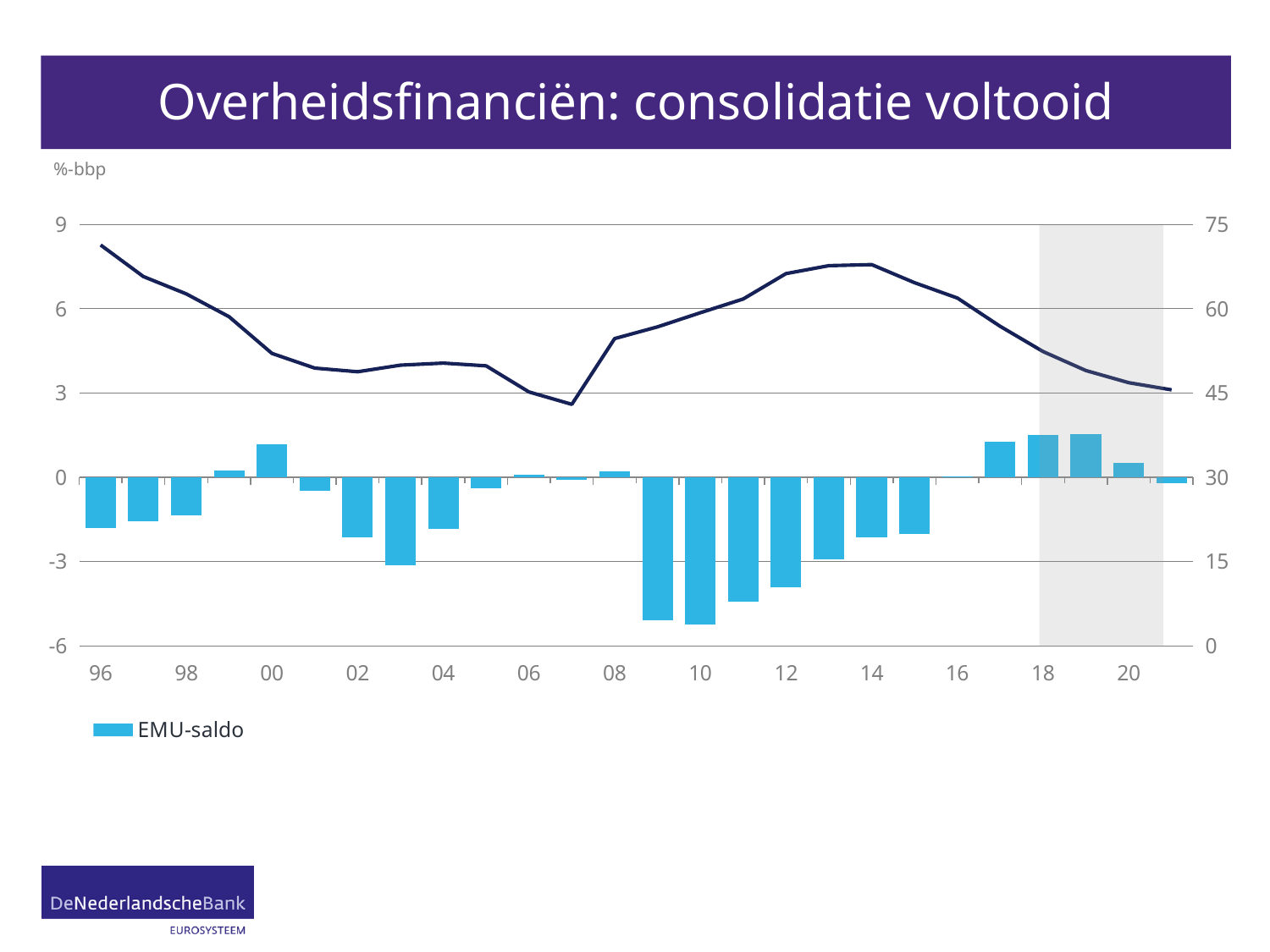
Is the line value for 2014 on the right axis greater or less than 60? greater Does the line rise or fall between 2014 and 2021? fall Is the line value for 2021 on the right axis greater or less than 60? less What series does the legend list for the bars? EMU-saldo How many series does the legend list? 1 Is the EMU-saldo bar for 2009 greater or less than -3? less What is the title of the chart on the slide? Overheidsfinanciën: consolidatie voltooid What kind of chart is shown on the slide? Combined bar and line chart Which year has the larger EMU-saldo bar, 2009 or 2013? 2013